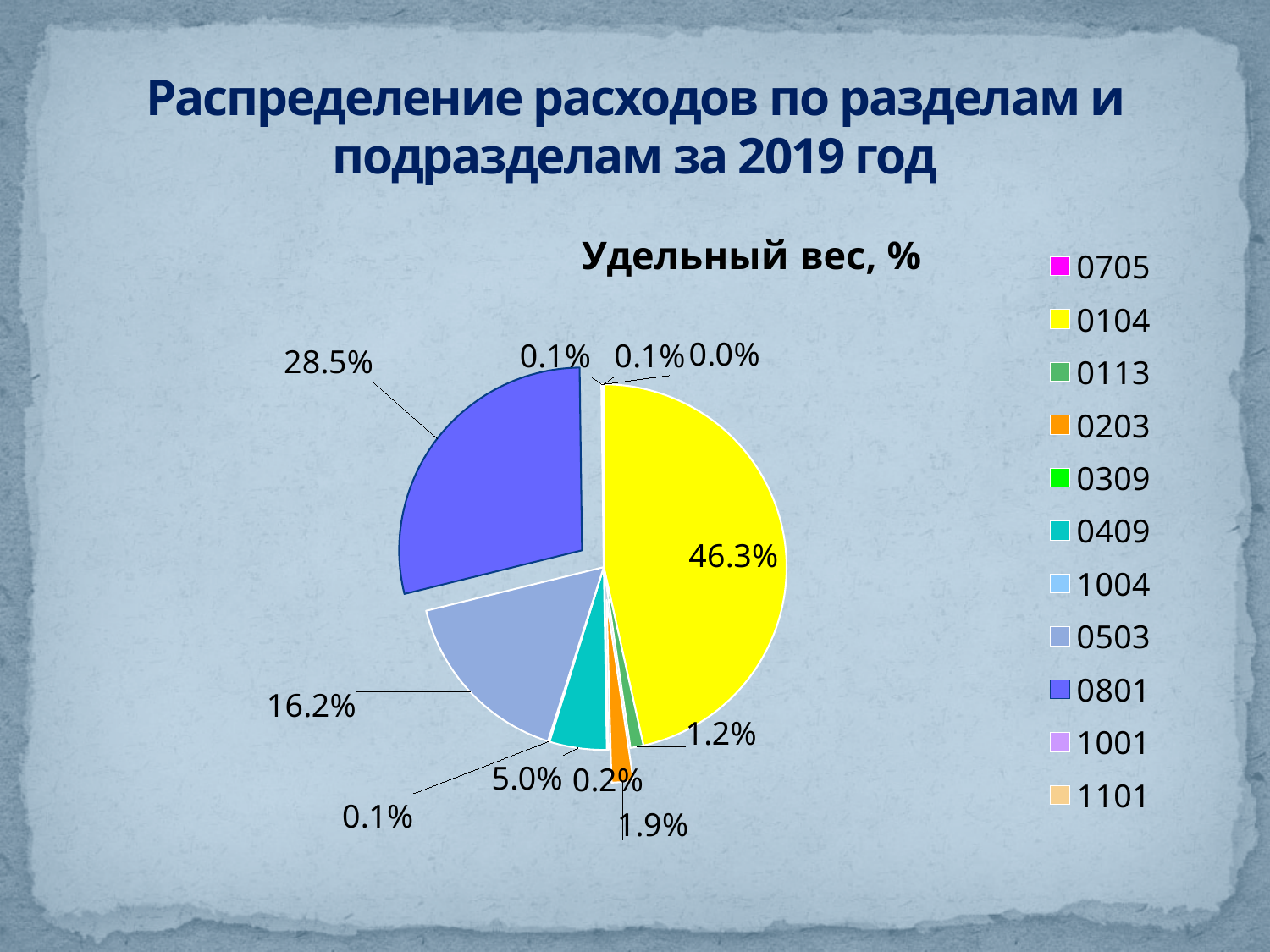
Which has a larger share, category 0503 or category 0409? 0503 What is the share of category 0503? 16.2% What is the share of category 0113? 1.2% What is the difference in percentage points between the shares of 0104 and 0801? 17.8 What is the title of the chart? Удельный вес, % Which category has the largest share of the pie? 0104 What is the share of category 0203? 1.9% What kind of chart is shown on the slide? Pie chart How many categories does the chart legend list? 11 What is the share of category 0409? 5.0% What is the share of category 0104? 46.3% What is the share of category 0801? 28.5%